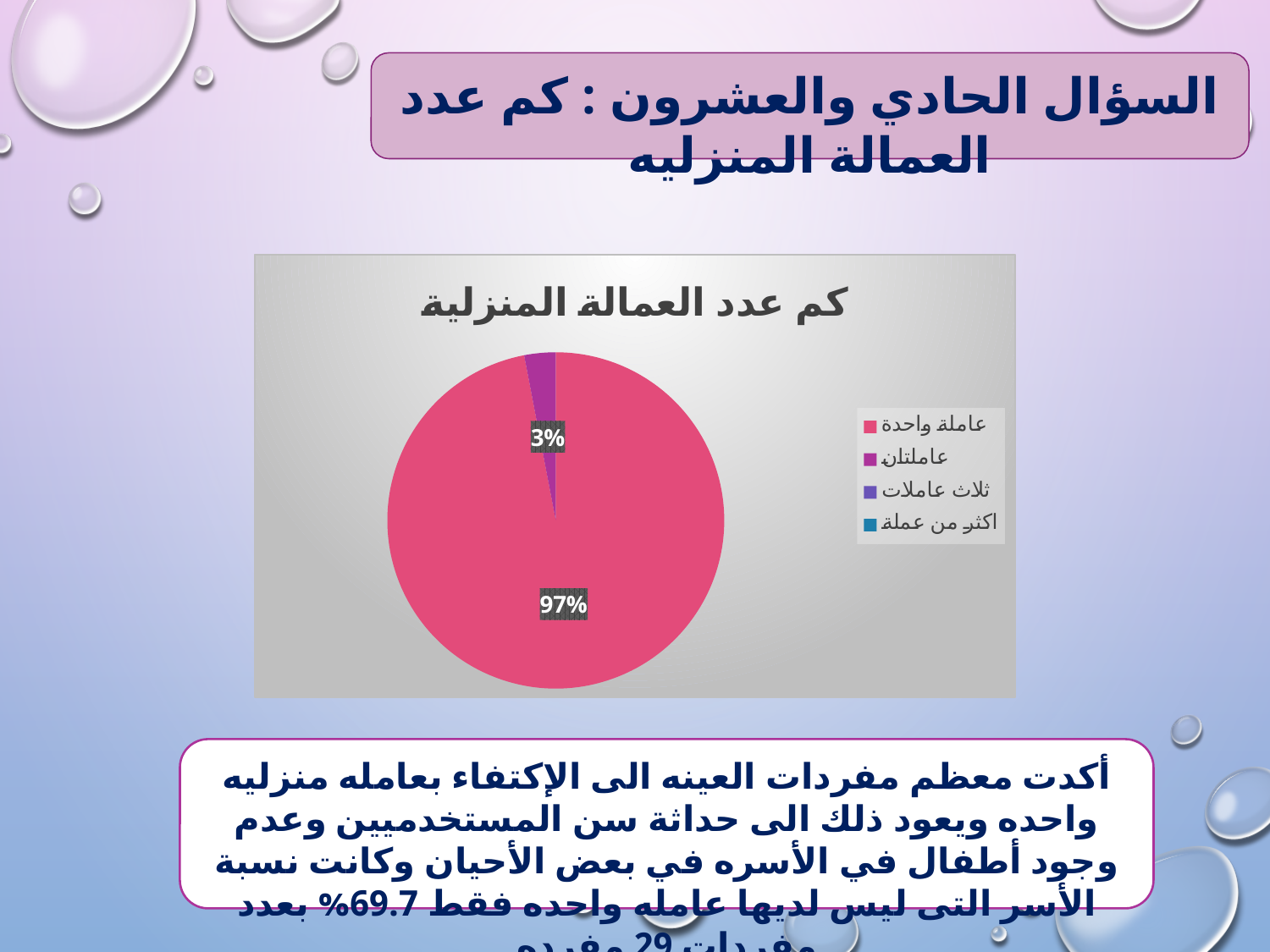
What colour is the slice representing عاملة واحدة? pink How many entries does the legend list? 4 What percentage of the pie is labelled for the category عاملتان? 3% What is the combined share of the عاملة واحدة and عاملتان slices? 100% How many data labels are printed on the pie? 2 What percentage of the pie is labelled for the category عاملة واحدة? 97% What type of chart is shown on the slide? pie chart Which is larger, the share for عاملة واحدة or the share for عاملتان? عاملة واحدة Which category has the largest share of the pie? عاملة واحدة What is the title of the chart? كم عدد العمالة المنزلية What is the difference in percentage points between the عاملة واحدة slice and the عاملتان slice? 94